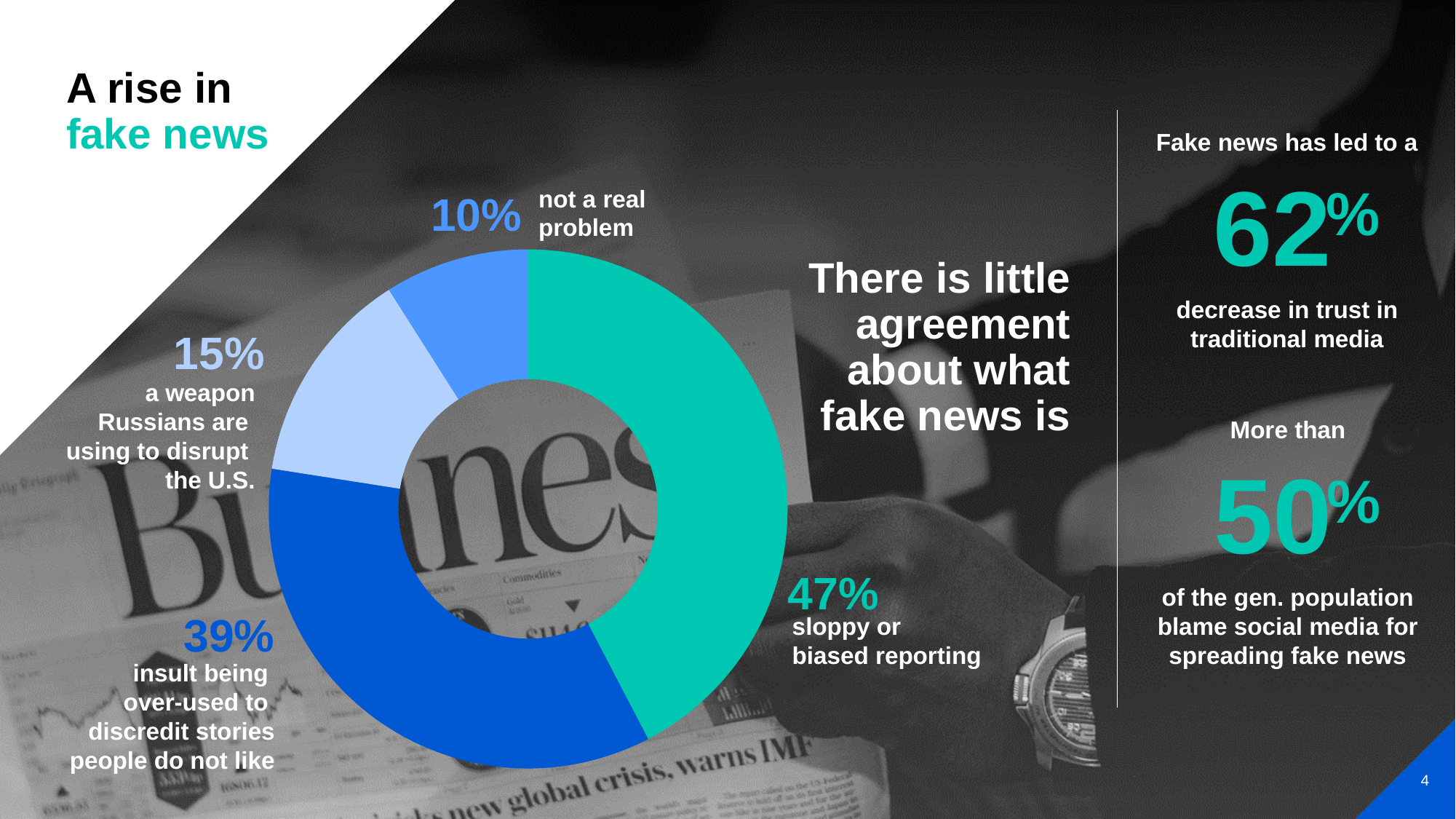
What is the combined share of 'a weapon Russians are using to disrupt the U.S.' and 'not a real problem'? 25% How many segments does the doughnut chart have? 4 What share of respondents say fake news is sloppy or biased reporting? 47% Which definition of fake news has the largest share in the chart? sloppy or biased reporting Which definition of fake news has the smallest share in the chart? not a real problem What is the difference in percentage points between 'sloppy or biased reporting' and 'insult being over-used to discredit stories people do not like'? 8 percentage points What colour is the segment for 'sloppy or biased reporting'? Teal (green) What share of respondents say fake news is an insult being over-used to discredit stories people do not like? 39% What share of respondents say fake news is a weapon Russians are using to disrupt the U.S.? 15% Which is larger: the share for 'a weapon Russians are using to disrupt the U.S.' or the share for 'not a real problem'? a weapon Russians are using to disrupt the U.S. What kind of chart is shown on the slide? Doughnut (pie) chart What share of respondents say fake news is not a real problem? 10%